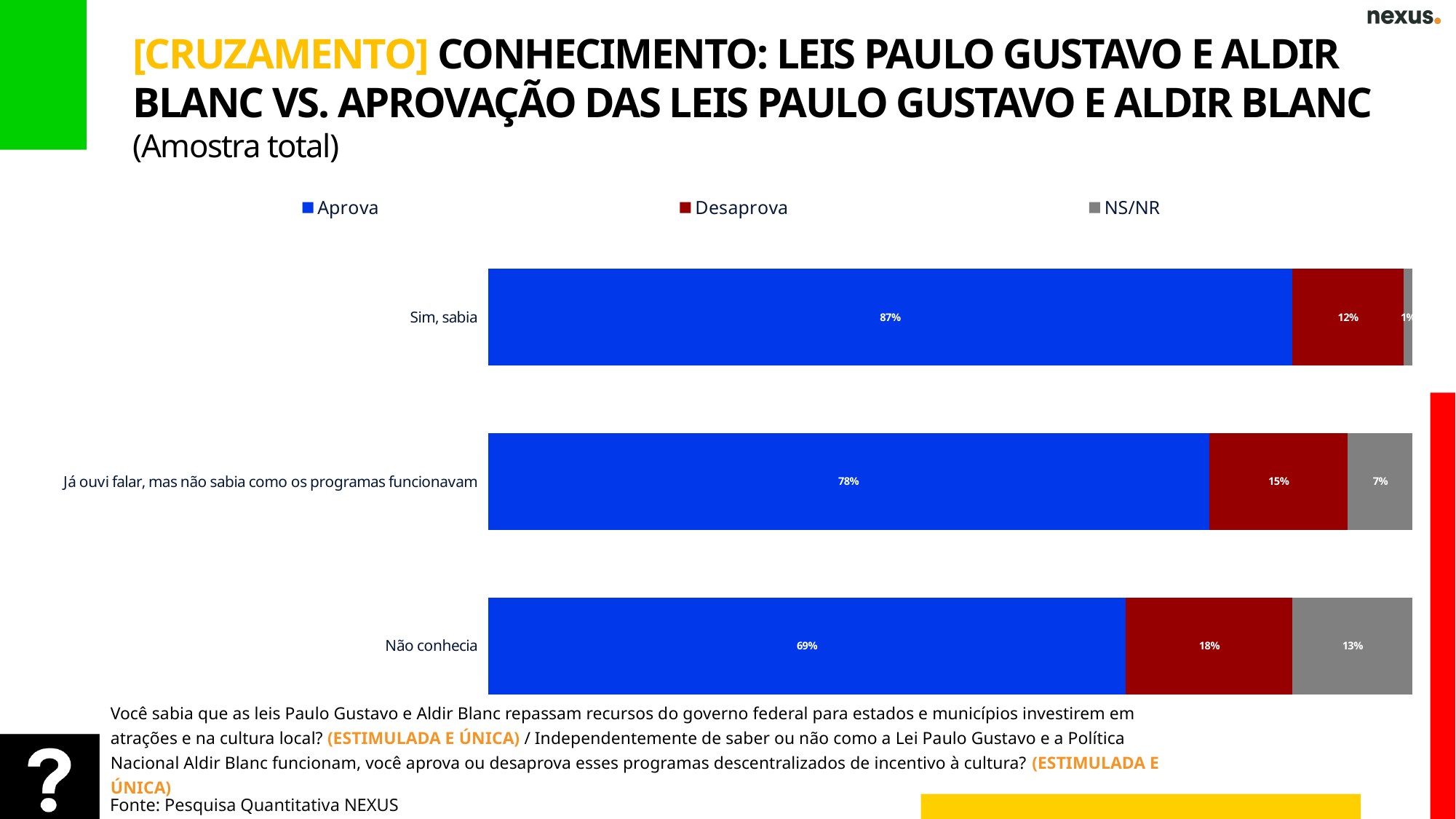
What is the Desaprova value for "Não conhecia"? 18% What is the NS/NR value for "Já ouvi falar, mas não sabia como os programas funcionavam"? 7% How many series does the legend list? 3 What is the Aprova value for "Sim, sabia"? 87% Which is larger: the Desaprova value for "Já ouvi falar, mas não sabia como os programas funcionavam" or for "Não conhecia"? Não conhecia Which category has the highest Aprova value? Sim, sabia Which category has the highest NS/NR value? Não conhecia What kind of chart is shown on the slide? Stacked bar chart How many categories are shown in the chart? 3 What is the difference between the Aprova values for "Sim, sabia" and "Não conhecia"? 18 percentage points What is the NS/NR value for "Sim, sabia"? 1% Which category has the lowest Aprova value? Não conhecia